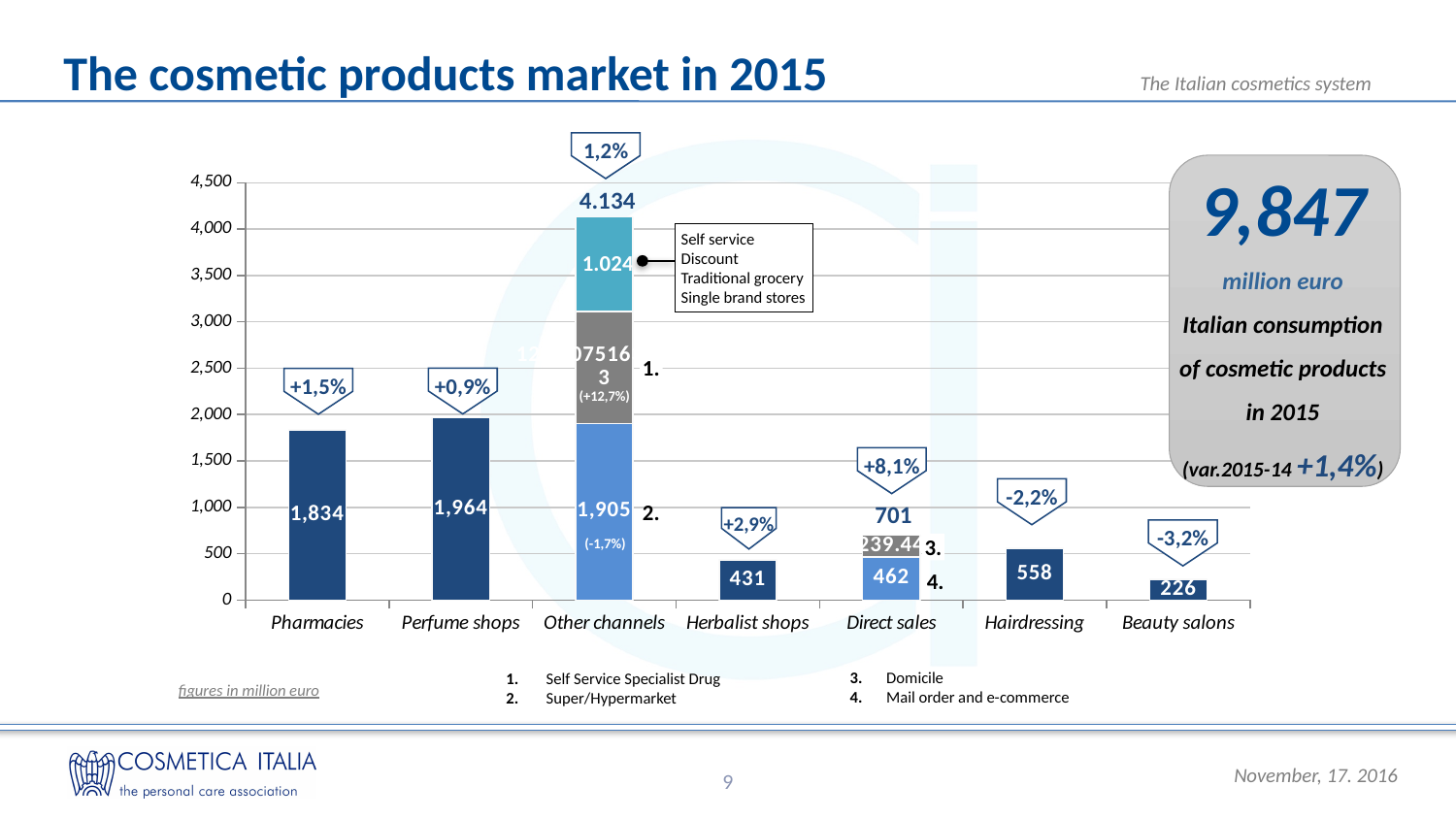
What kind of chart is shown on the slide? Bar chart Which channel has the lowest value? Beauty salons What is the total of the stacked bar for Other channels? 4.134 Which channel has the highest total value? Other channels What percentage change is shown above the Direct sales bar? +8,1% How many channels are shown on the x axis? 7 What is the difference between the values for Perfume shops and Pharmacies? 130 Which is larger, the value for Hairdressing or for Herbalist shops? Hairdressing What is the value for Perfume shops? 1,964 What is the value for Pharmacies? 1,834 What is the value for Beauty salons? 226 What is the value for Herbalist shops? 431